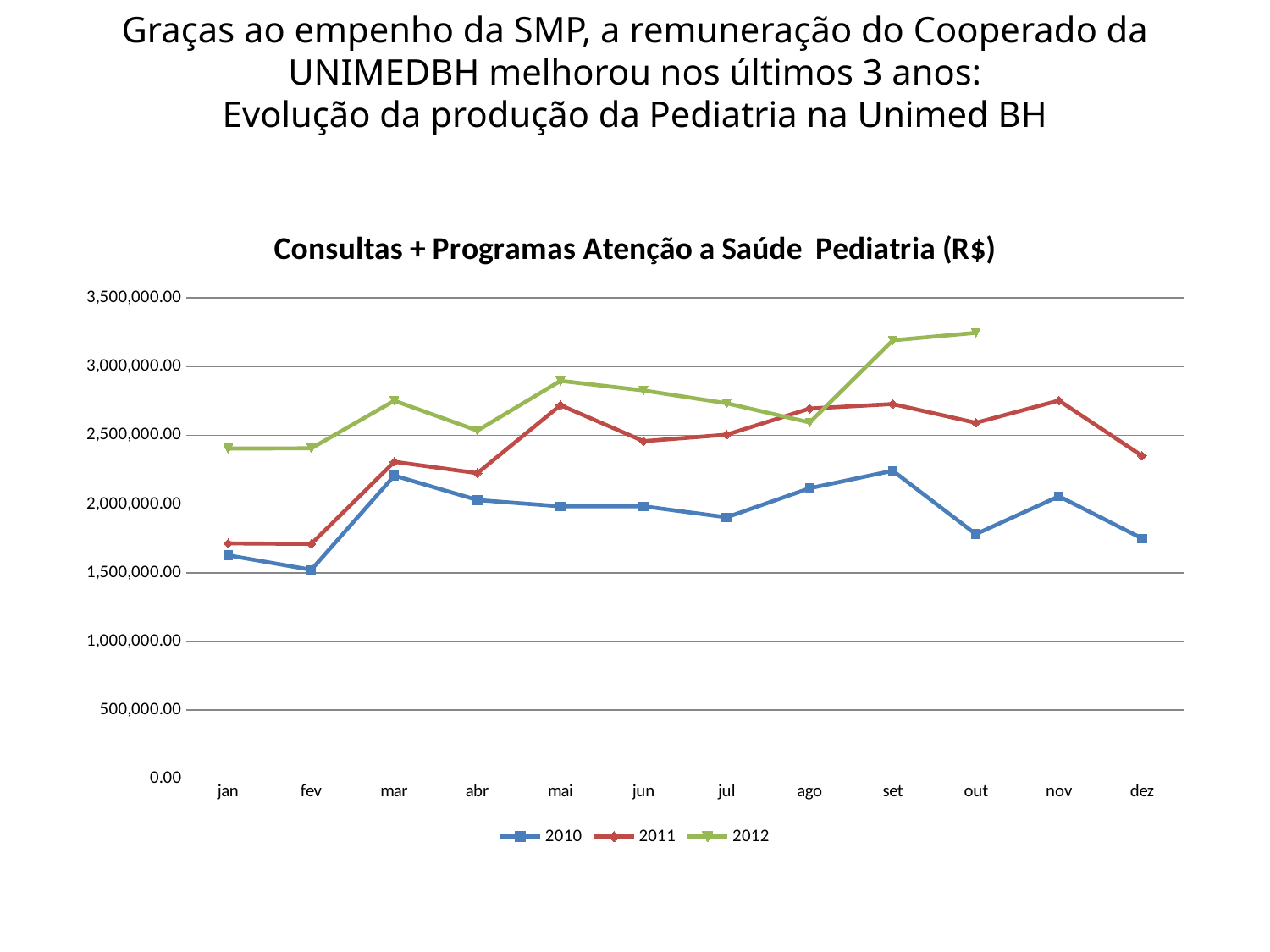
Which month has the highest value for the 2012 series? out Is the value for 2011 in jan greater or less than 2,000,000.00? less What kind of chart is shown on the slide? line chart Is the value for 2012 in jan greater or less than 2,500,000.00? less Which month has the lowest value for the 2010 series? fev Is the value for 2012 in out greater or less than 3,000,000.00? greater In jan, which series has the larger value, 2010 or 2012? 2012 How many months are shown along the x axis? 12 Does the 2012 series rise or fall from ago to out? rise What is the title of the chart? Consultas + Programas Atenção a Saúde Pediatria (R$) How many series does the legend list? 3